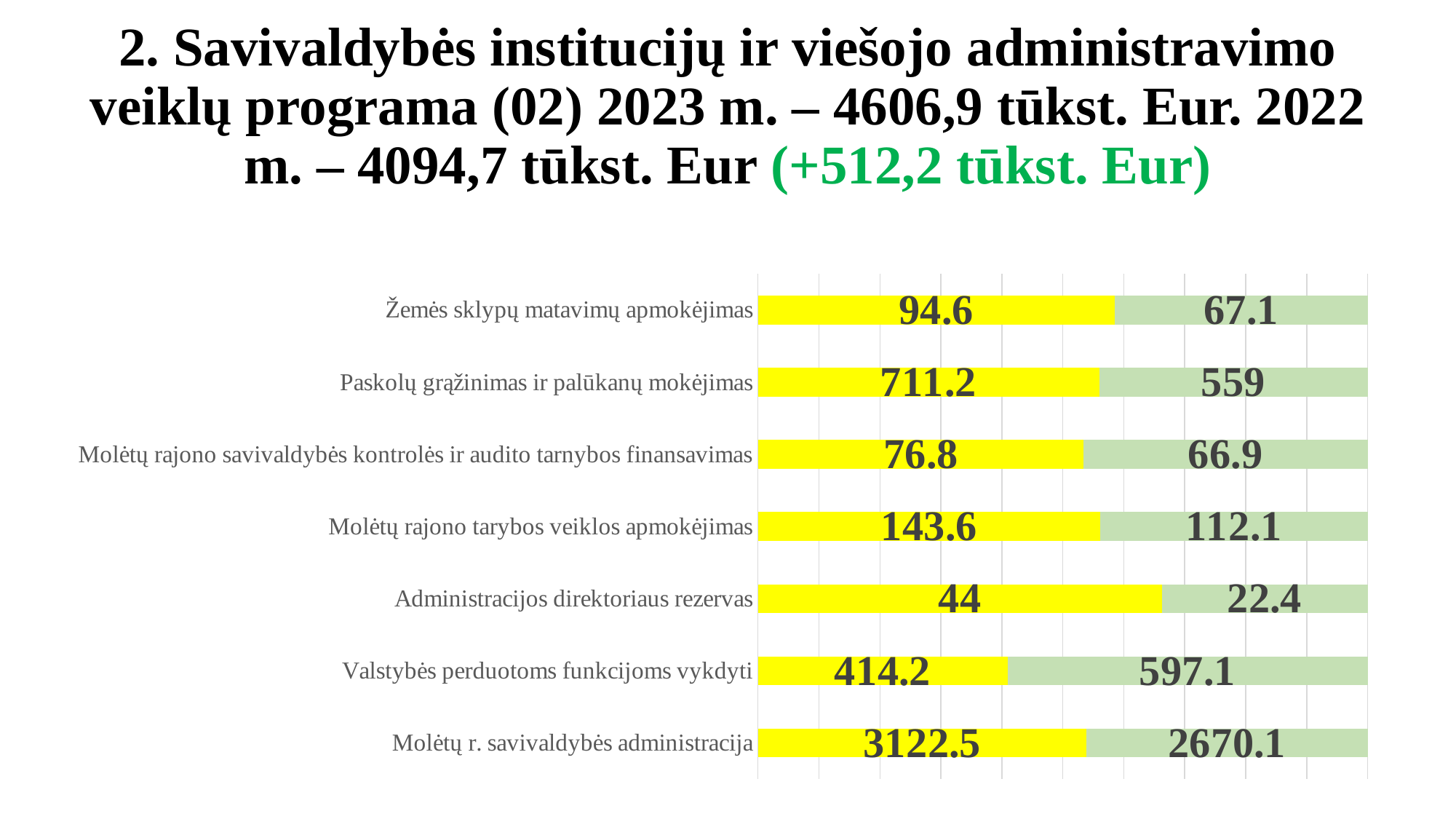
What is the value of the green segment for Molėtų r. savivaldybės administracija? 2670.1 What is the difference between the yellow and green values for Paskolų grąžinimas ir palūkanų mokėjimas? 152.2 How many coloured segments does each bar in the chart have? 2 What is the value of the yellow segment for Paskolų grąžinimas ir palūkanų mokėjimas? 711.2 What is the value of the yellow segment for Administracijos direktoriaus rezervas? 44 How many categories are shown in the chart? 7 What kind of chart is shown on the slide? bar chart Which category has the highest yellow-segment value? Molėtų r. savivaldybės administracija Which category has the lowest green-segment value? Administracijos direktoriaus rezervas What is the value of the green segment for Molėtų rajono tarybos veiklos apmokėjimas? 112.1 What is the sum of the yellow and green values for Žemės sklypų matavimų apmokėjimas? 161.7 For Valstybės perduotoms funkcijoms vykdyti, which segment has the larger value, yellow or green? green